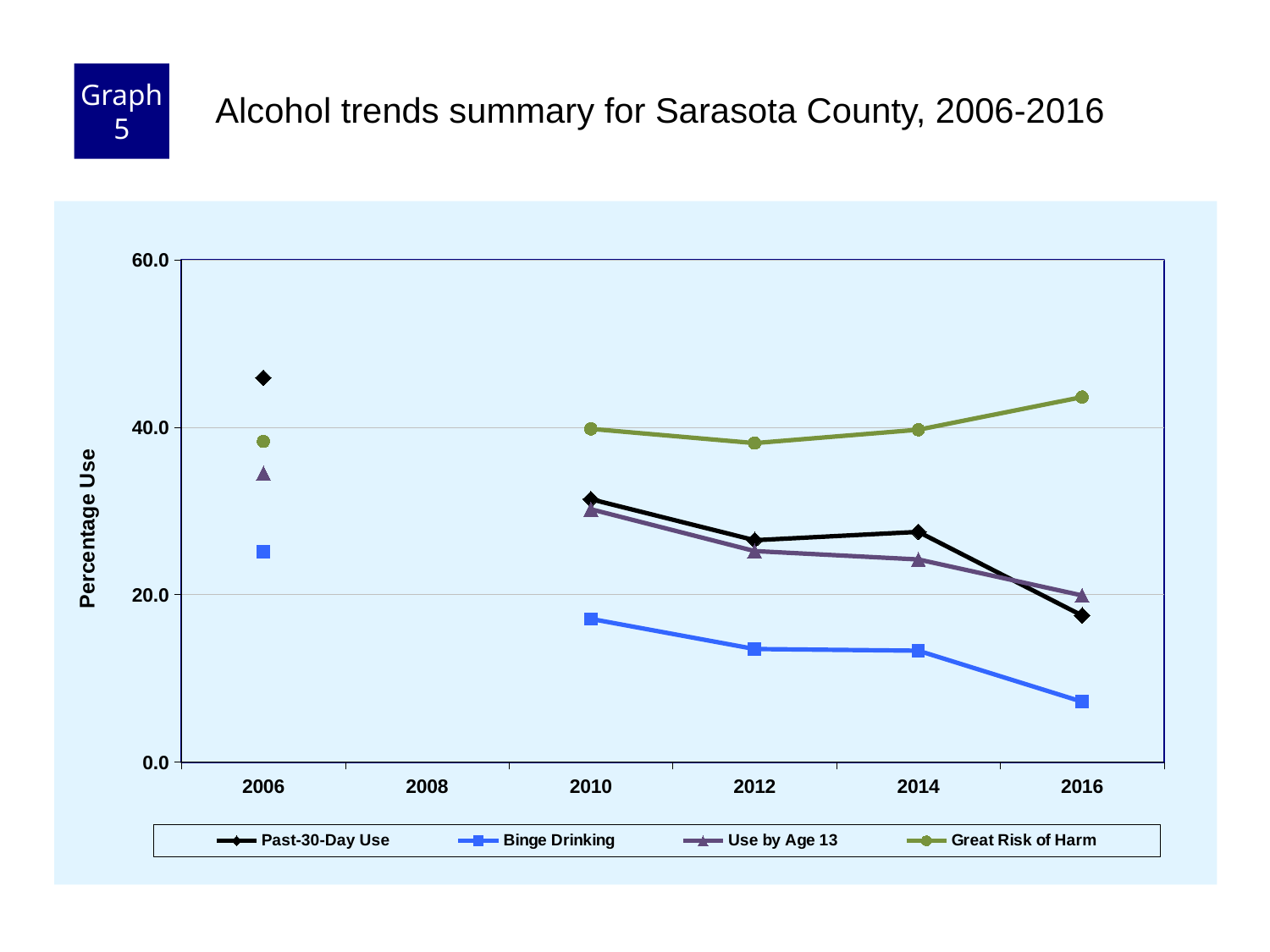
In 2010, which is larger: Past-30-Day Use or Binge Drinking? Past-30-Day Use Does the Binge Drinking series rise or fall from 2010 to 2016? Fall Is the value for Great Risk of Harm in 2016 greater or less than 40.0? greater Is the value for Use by Age 13 in 2006 greater or less than 40.0? less Which series has the highest value in 2016? Great Risk of Harm Which series has the lowest value in 2016? Binge Drinking What is the label on the y axis? Percentage Use Is the value for Past-30-Day Use in 2006 greater or less than 40.0? greater How many years are labelled on the x axis? 6 What kind of chart is shown on the slide? Line chart How many series does the legend list? 4